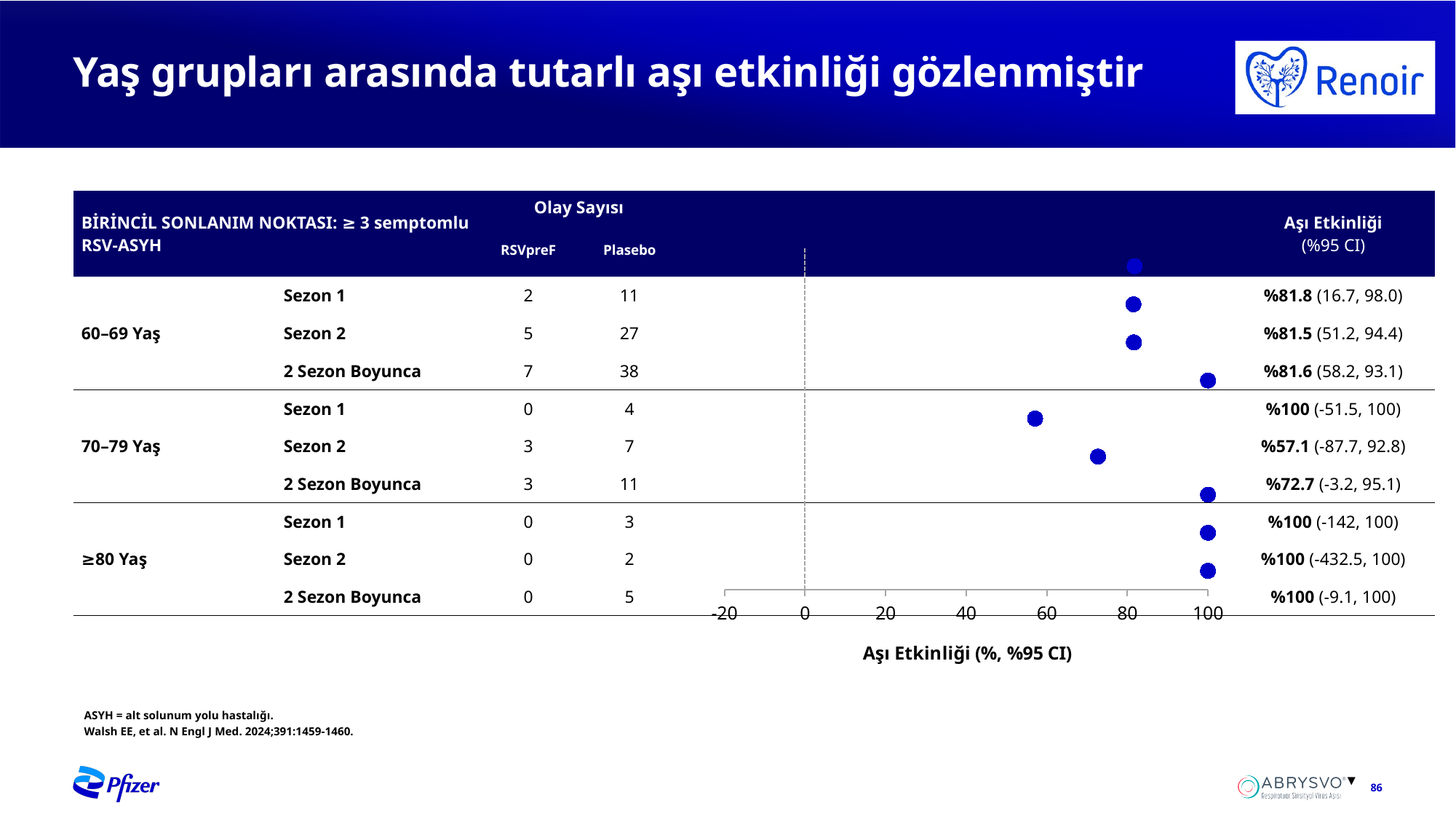
What kind of chart is used to show the vaccine efficacy values? Dot plot (scatter chart) Which has the higher plotted vaccine efficacy: 60–69 Yaş Sezon 1 or 70–79 Yaş Sezon 2? 60–69 Yaş Sezon 1 How many data points are plotted in the chart? 9 What is the vaccine efficacy (Aşı Etkinliği) plotted for 60–69 Yaş, Sezon 1? %81.8 What is the vaccine efficacy plotted for 70–79 Yaş, 2 Sezon Boyunca? %72.7 What is the vaccine efficacy plotted for 70–79 Yaş, Sezon 2? %57.1 What is the label of the chart's x axis? Aşı Etkinliği (%, %95 CI) Is the plotted vaccine efficacy for 70–79 Yaş Sezon 2 greater or less than 60? less Which row has the lowest plotted vaccine efficacy? 70–79 Yaş, Sezon 2 How many rows have a plotted vaccine efficacy of %100? 4 What is the vaccine efficacy plotted for 60–69 Yaş, 2 Sezon Boyunca? %81.6 What is the difference in vaccine efficacy between 70–79 Yaş 2 Sezon Boyunca and 70–79 Yaş Sezon 2? 15.6 percentage points